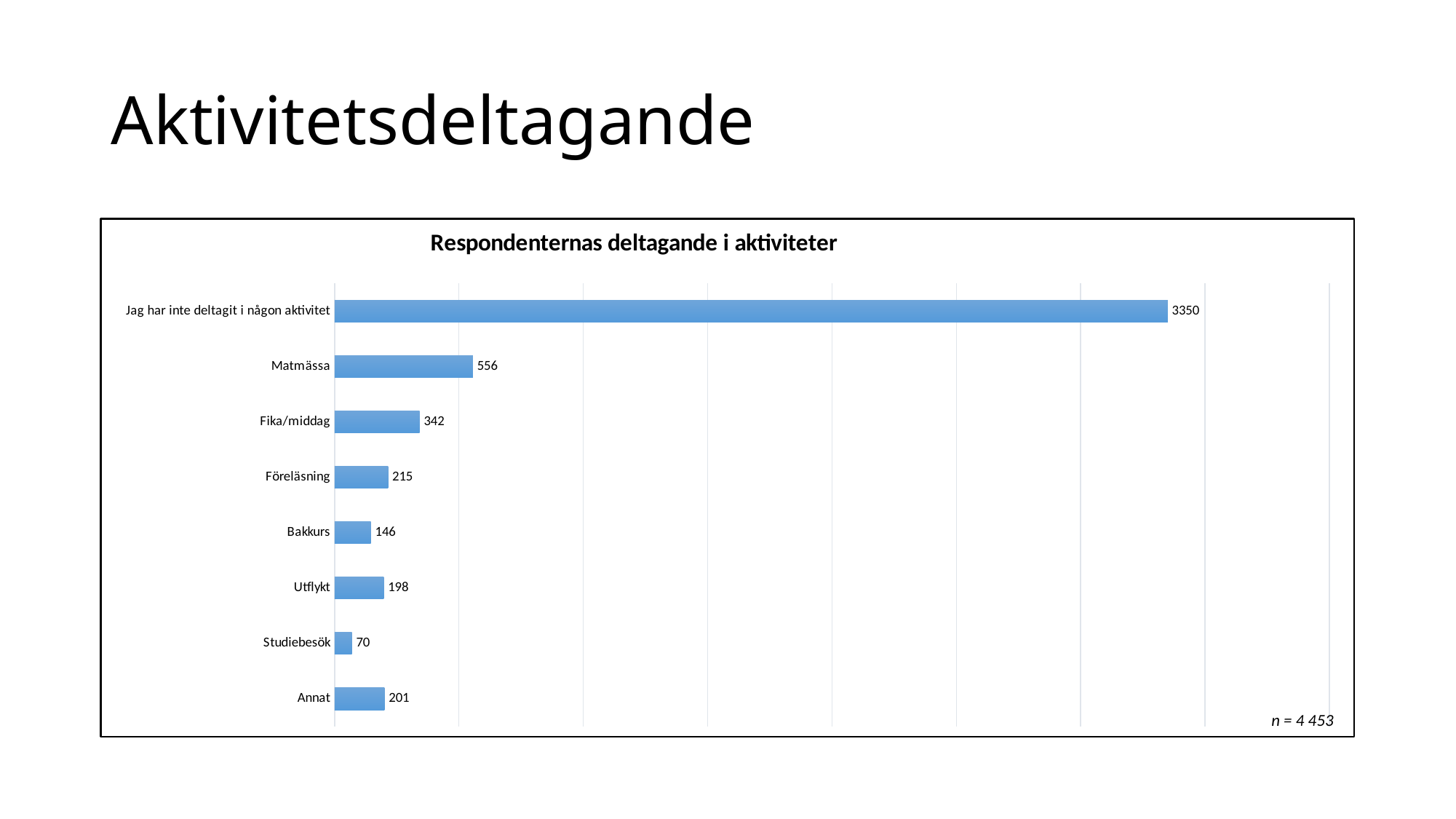
Which category has the lowest value? Studiebesök Which is larger, the value for Utflykt or the value for Bakkurs? Utflykt What is the value for Bakkurs? 146 What is the value for Fika/middag? 342 What sample size (n) is noted on the chart? n = 4 453 What is the difference between the values for Matmässa and Fika/middag? 214 What is the title of the chart? Respondenternas deltagande i aktiviteter What is the value for Matmässa? 556 What kind of chart is shown on the slide? Bar chart How many categories are shown in the chart? 8 What is the value for Studiebesök? 70 Which category has the highest value? Jag har inte deltagit i någon aktivitet